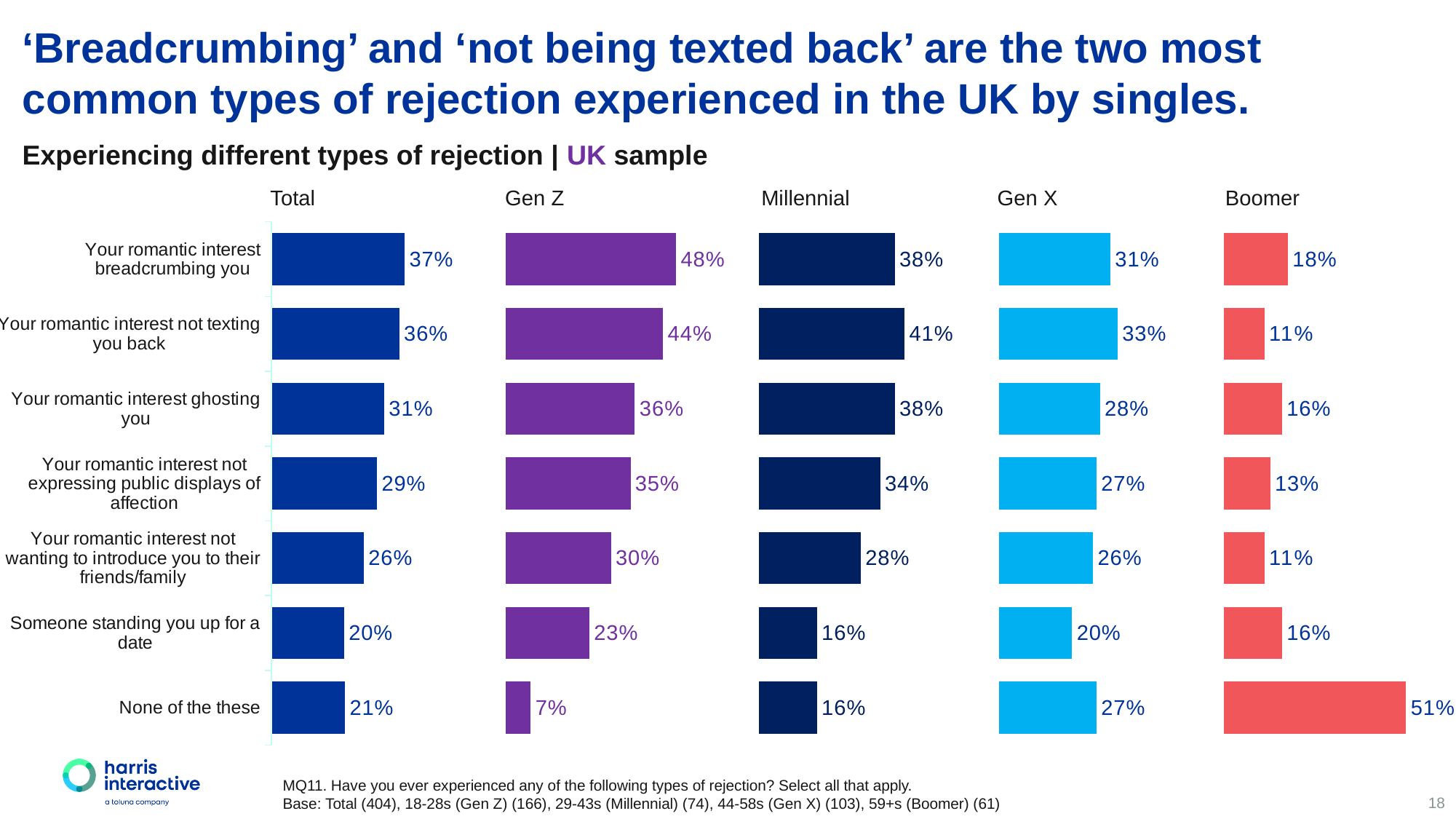
In the Gen Z chart, which category has the lowest value? None of the these In the Boomer chart, which category has the highest value? None of the these How many separate charts (generation groups) are shown on the slide? 5 In the Millennial chart, what is the difference between 'Your romantic interest not texting you back' and 'Someone standing you up for a date'? 25% In the Gen X chart, what is the value for 'Your romantic interest not expressing public displays of affection'? 27% How many categories are shown in the Total chart? 7 In the Boomer chart, what is the value for 'None of the these'? 51% What type of chart is used for the Millennial data? Bar chart In the Gen Z chart, which category has the highest value? Your romantic interest breadcrumbing you In the Total chart, what is the value for 'Your romantic interest breadcrumbing you'? 37% In the Gen Z chart, what is the value for 'Your romantic interest not texting you back'? 44% In the Gen X chart, which is larger: 'Your romantic interest not texting you back' or 'Your romantic interest ghosting you'? Your romantic interest not texting you back